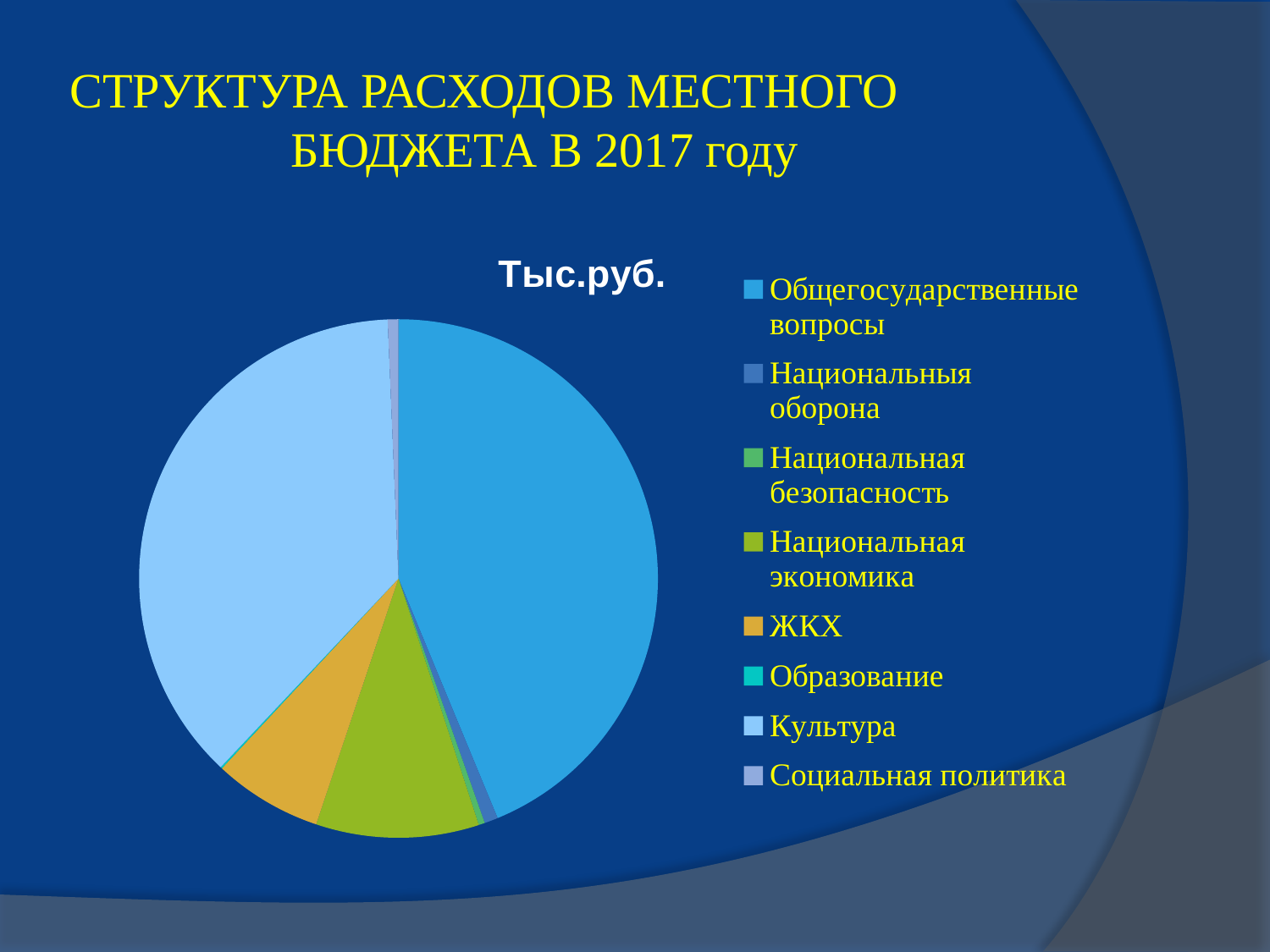
Which category is the second-largest slice of the pie? Культура Which category has the largest slice of the pie? Общегосударственные вопросы What colour is the ЖКХ slice in the pie chart? orange What is the title of the chart? Тыс.руб. What kind of chart is shown on the slide? pie chart Which slice is larger: Культура or ЖКХ? Культура Which slice is larger: Общегосударственные вопросы or Культура? Общегосударственные вопросы Which slice is larger: Национальная экономика or ЖКХ? Национальная экономика How many categories does the pie chart's legend list? 8